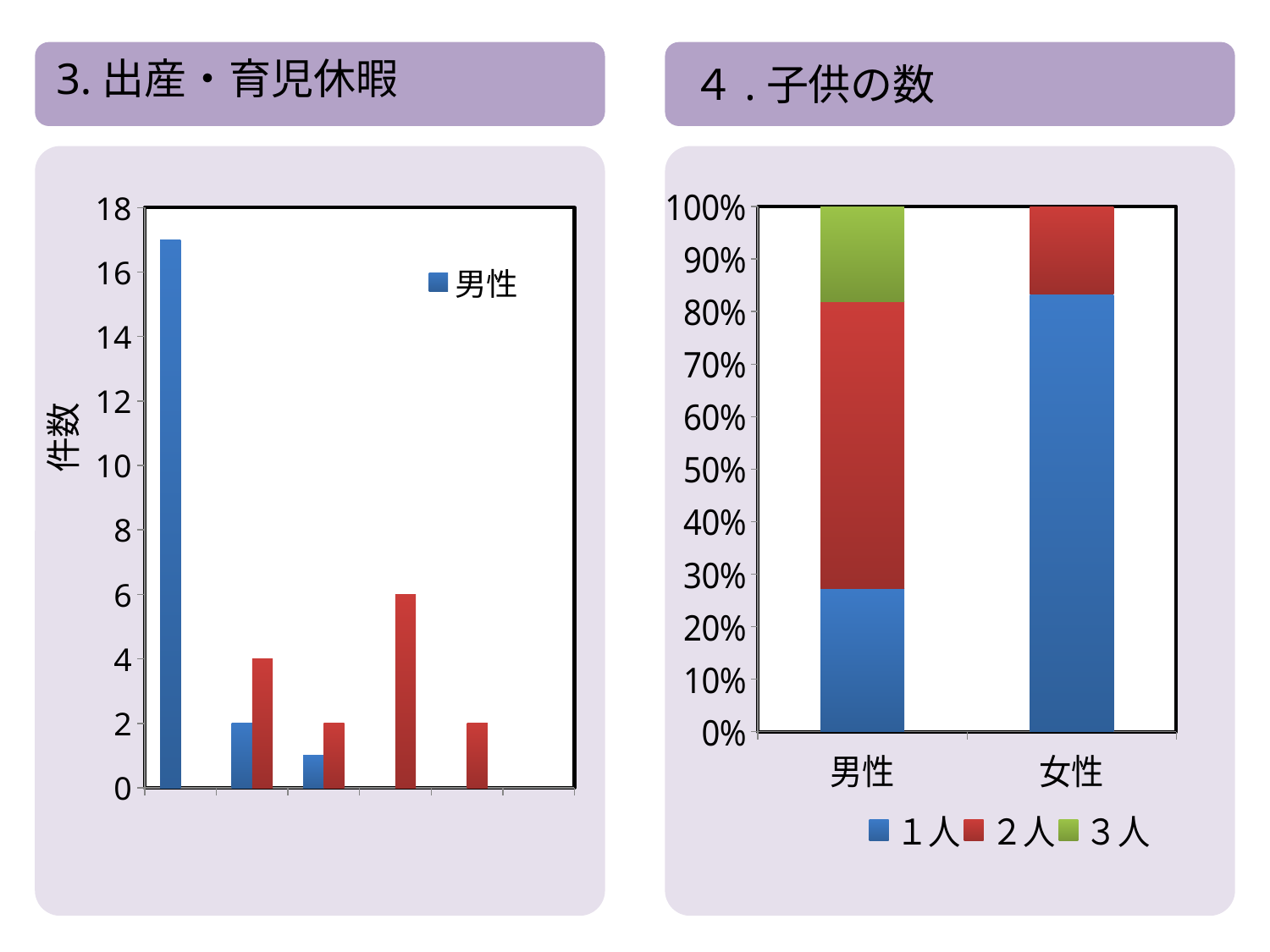
In the chart under "4．子供の数", is the share of 1人 for 女性 greater or less than 80%? greater In the chart under "4．子供の数", which category has the larger share of 1人, 男性 or 女性? 女性 In the chart under "4．子供の数", what are the legend entries? 1人, 2人, 3人 In the chart under "3. 出産・育児休暇", is the value of the tallest bar greater or less than 16? greater In the chart under "4．子供の数", how many series does the legend list? 3 What kind of chart is shown under "4．子供の数"? Stacked bar chart In the chart under "3. 出産・育児休暇", how many bars are plotted? 7 In the chart under "4．子供の数", is the share of 1人 for 男性 greater or less than 30%? less In the chart under "3. 出産・育児休暇", how many series does the legend list? 1 In the chart under "4．子供の数", which category has a 3人 segment? 男性 In the chart under "4．子供の数", how many categories are shown on the x axis? 2 What kind of chart is shown under "3. 出産・育児休暇"? Bar chart